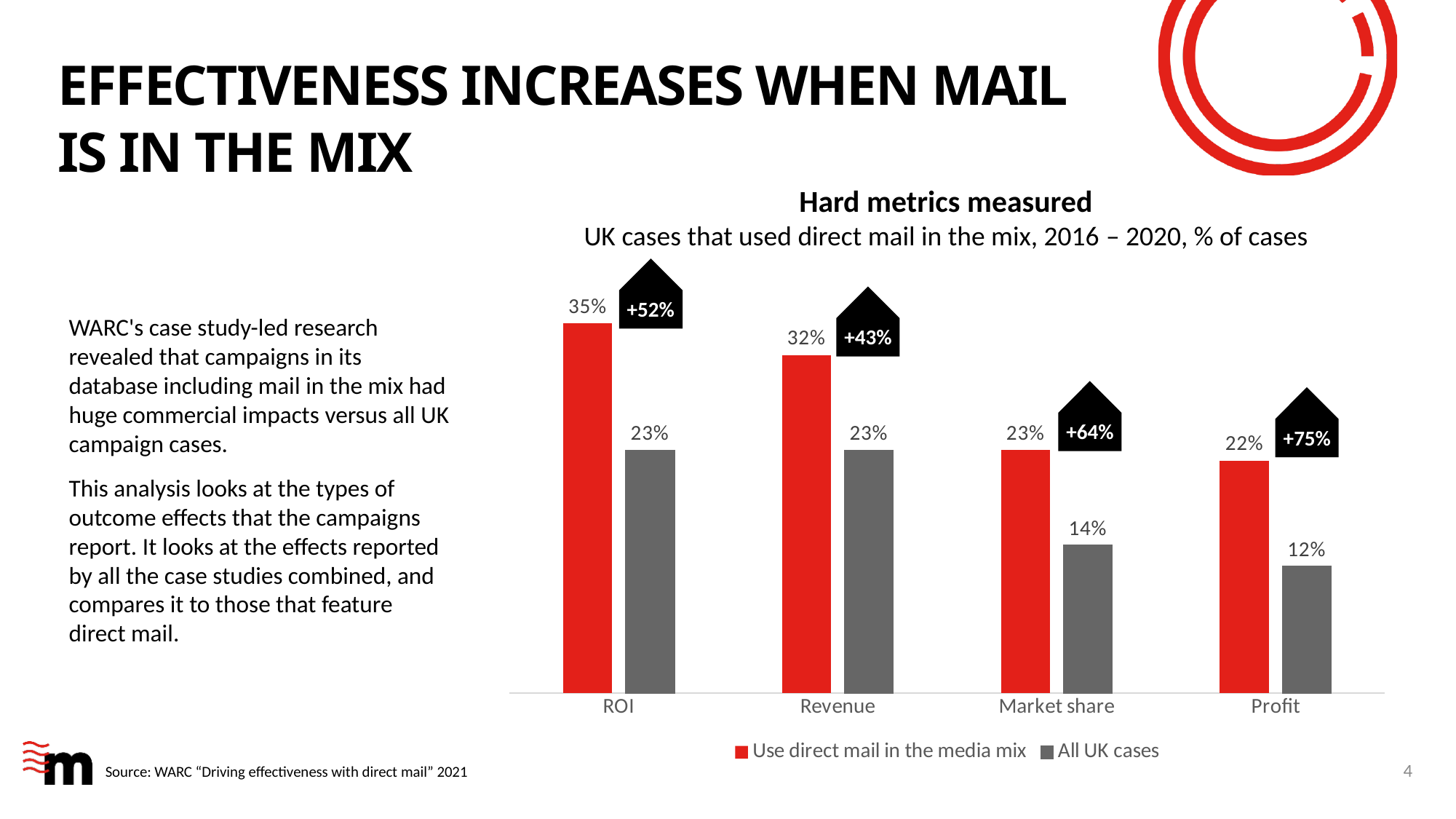
What is the value for Market share in the 'All UK cases' series? 14% Which category has the highest value in the 'Use direct mail in the media mix' series? ROI How many categories are shown on the x axis? 4 What is the difference between the 'Use direct mail in the media mix' and 'All UK cases' values for Revenue? 9% What kind of chart is shown on the slide? Bar chart How many series does the legend list? 2 Which category has the lowest value in the 'All UK cases' series? Profit What uplift percentage is shown in the black marker above the Profit bars? +75% Which is larger for Market share: 'Use direct mail in the media mix' or 'All UK cases'? Use direct mail in the media mix What is the value for ROI in the 'Use direct mail in the media mix' series? 35% What is the title of the chart? Hard metrics measured What is the value for Profit in the 'All UK cases' series? 12%